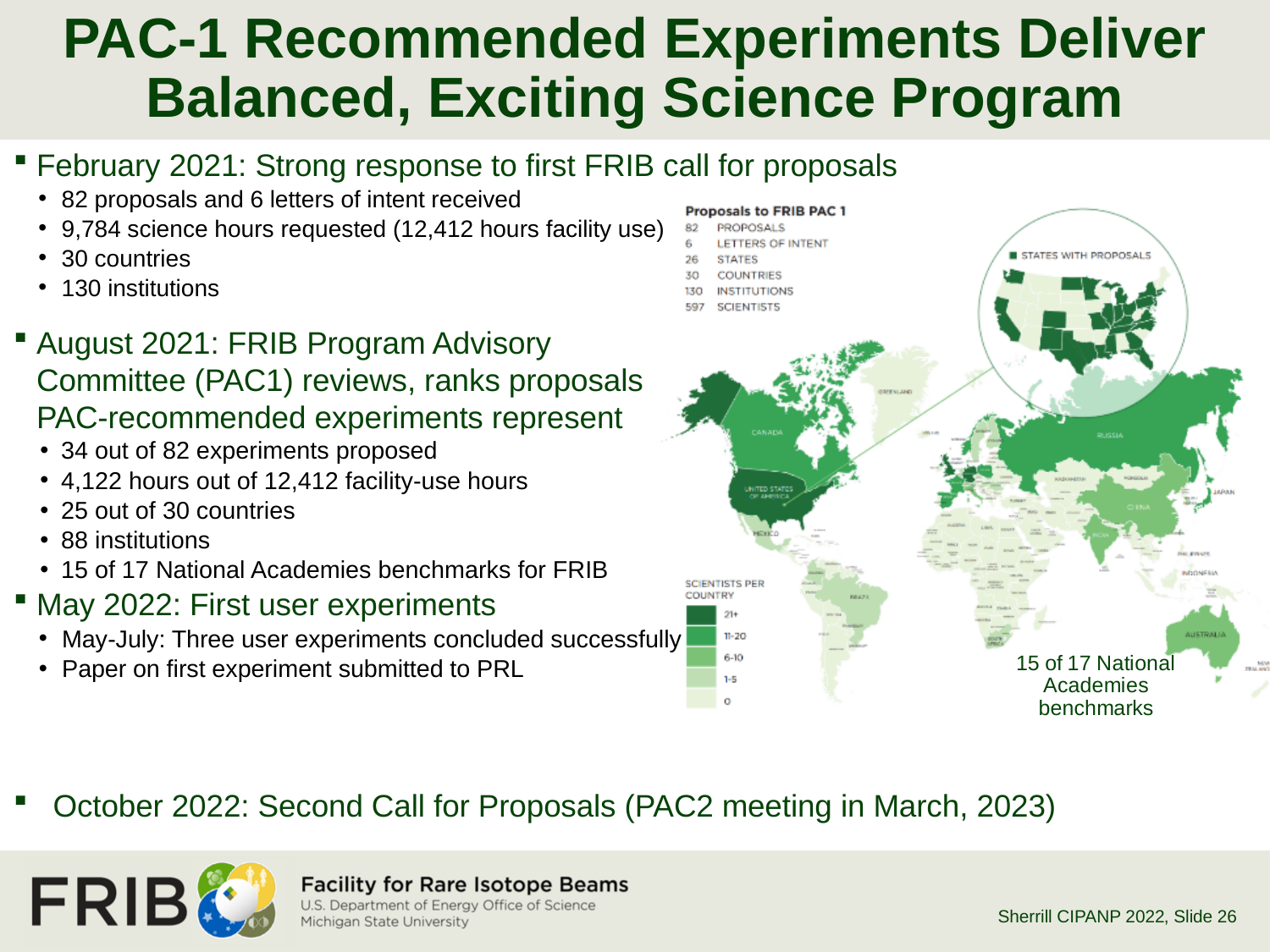
What is the highest range shown in the 'Scientists per country' legend on the map? 21+ According to the 'Proposals to FRIB PAC 1' infographic, how many states submitted proposals? 26 What kind of chart is used to show scientists per country? Map chart What is the lowest value shown in the 'Scientists per country' legend on the map? 0 According to the 'Proposals to FRIB PAC 1' infographic, how many proposals were received? 82 According to the 'Proposals to FRIB PAC 1' infographic, how many letters of intent were received? 6 How many shade categories does the 'Scientists per country' legend on the map list? 5 According to the 'Proposals to FRIB PAC 1' infographic, how many scientists are listed? 597 What is the title of the infographic shown on the map chart? Proposals to FRIB PAC 1 What does the circular inset on the map chart highlight? States with proposals According to the 'Proposals to FRIB PAC 1' infographic, how many countries are listed? 30 According to the 'Proposals to FRIB PAC 1' infographic, how many institutions are listed? 130